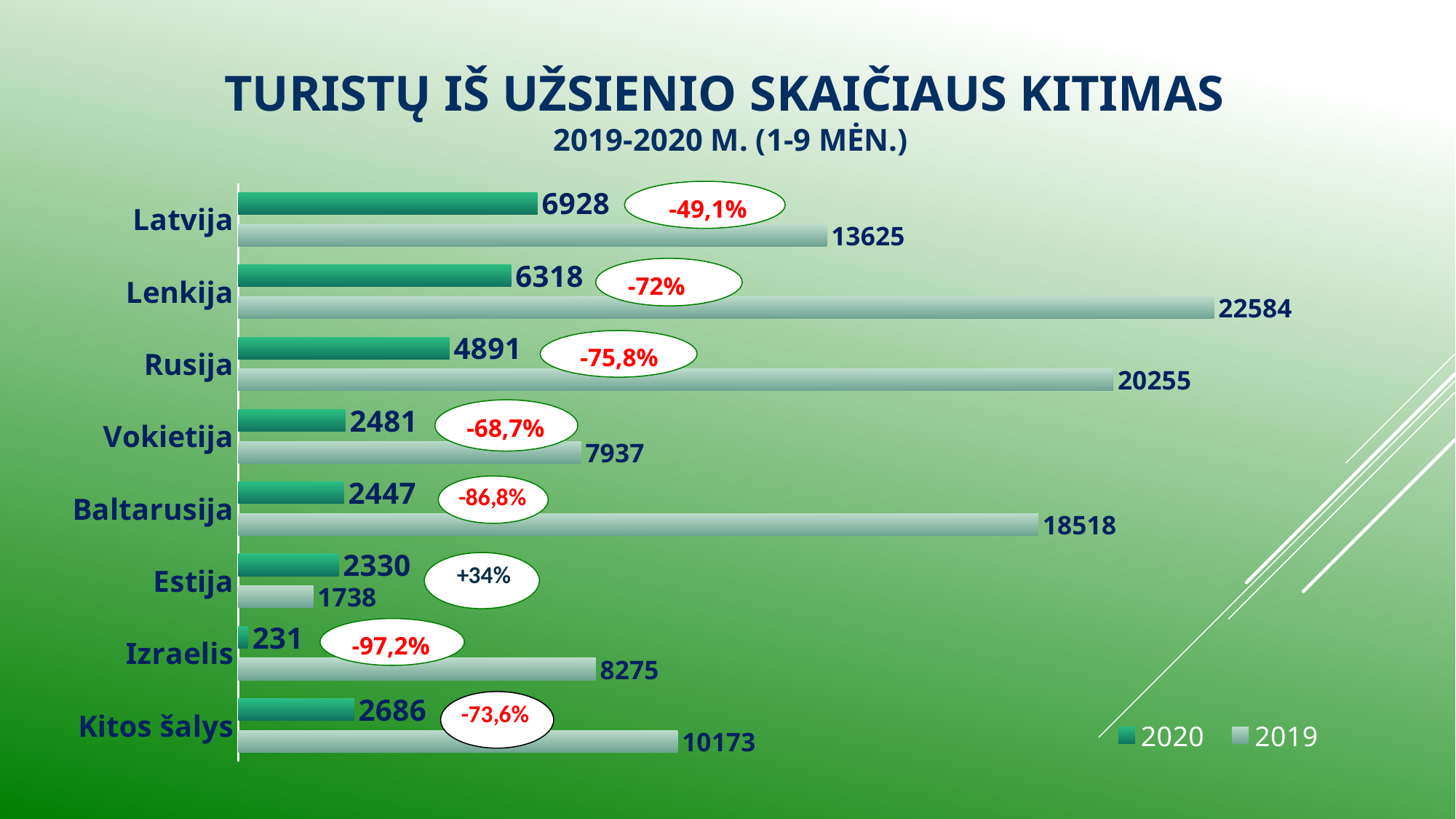
How many series does the legend list? 2 What are the two series listed in the legend? 2020 and 2019 What percentage change is shown for Izraelis? -97,2% Which category has the lowest 2019 value? Estija What is the 2020 value for Latvija? 6928 What is the 2019 value for Baltarusija? 18518 Which category has the highest 2019 value? Lenkija What is the difference between the 2019 and 2020 values for Rusija? 15364 How many categories are shown on the chart? 8 Which category has the lowest 2020 value? Izraelis What kind of chart is shown on the slide? bar chart Which is larger for Estija, the 2020 value or the 2019 value? 2020